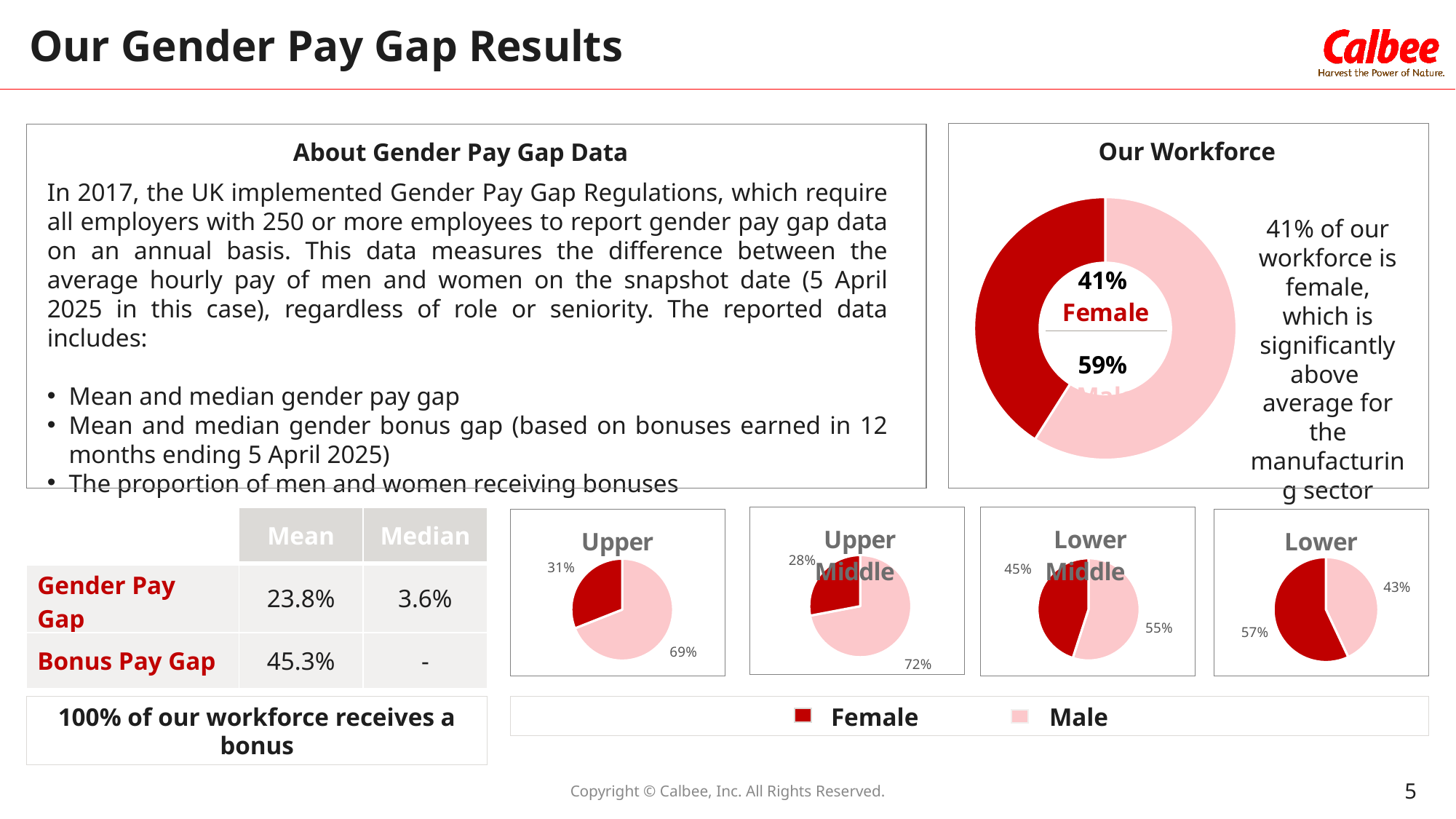
In the 'Lower' pie chart, what is the male share? 43% What is the difference between the male and female shares in the 'Upper' pie chart? 38% In the 'Upper Middle' pie chart, what is the male share? 72% In the 'Our Workforce' chart, what percentage of the workforce is female? 41% How many entries does the legend below the pay quartile pie charts list? 2 In the 'Lower Middle' pie chart, what is the female share? 45% In the 'Upper' pie chart, what is the female share? 31% Across the four pay quartile pie charts, which quartile has the highest female share? Lower What kind of chart is the 'Our Workforce' chart? Donut chart Across the four pay quartile pie charts, which quartile has the lowest female share? Upper Middle In the 'Lower' pie chart, which is larger, the female share or the male share? Female In the 'Our Workforce' chart, what percentage of the workforce is male? 59%